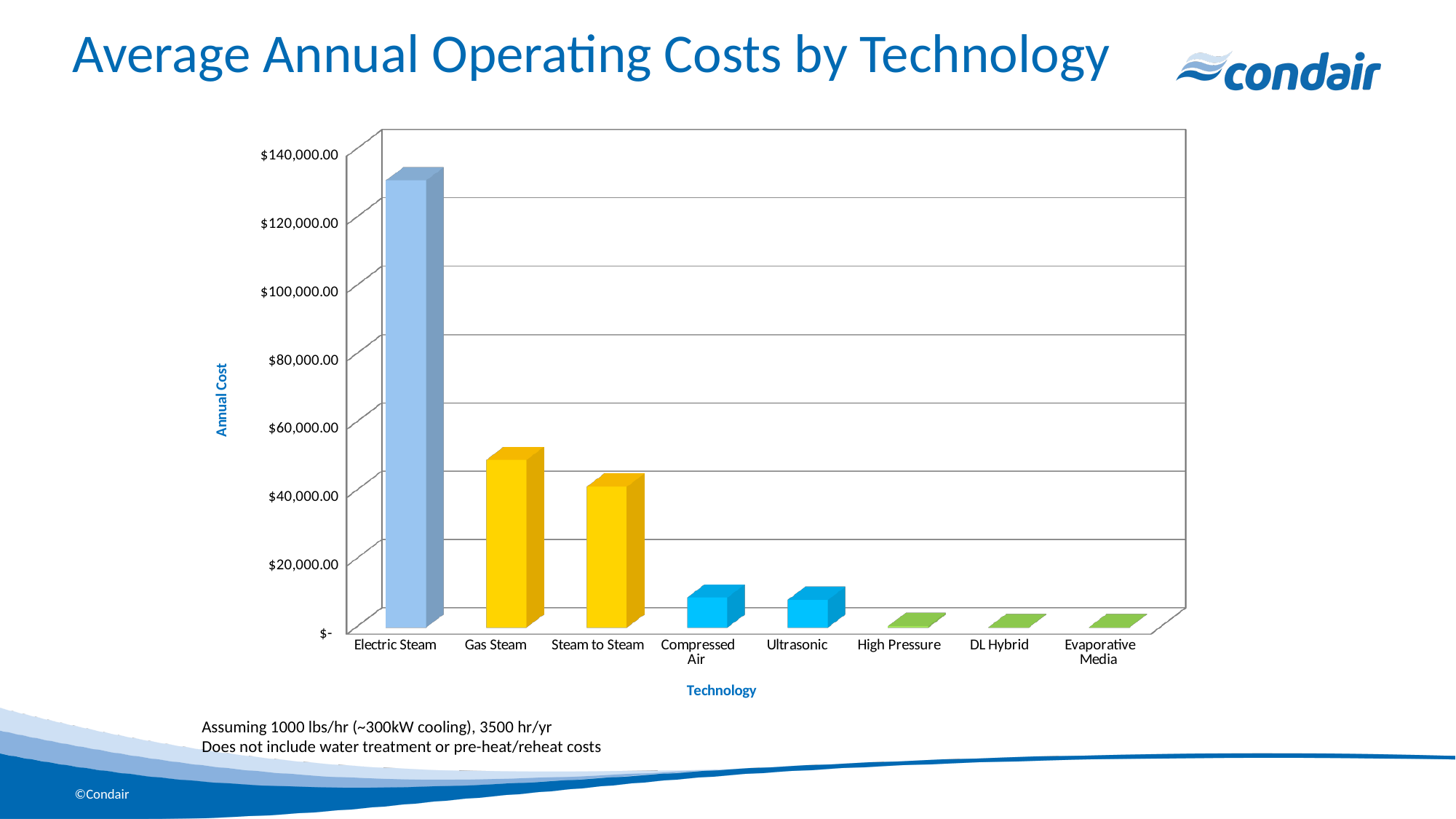
What kind of chart is shown on the slide? Bar chart Is the value for Electric Steam greater or less than $120,000.00? greater Which has a higher annual cost, Electric Steam or Gas Steam? Electric Steam Is the value for Compressed Air greater or less than $20,000.00? less Do the annual cost values generally rise or fall moving left to right along the x axis? Fall What is the title of the vertical axis of the chart? Annual Cost Is the value for Steam to Steam greater or less than $60,000.00? less How many technologies are shown on the x axis of the chart? 8 Which has a higher annual cost, Gas Steam or Steam to Steam? Gas Steam Which technology has the highest average annual operating cost? Electric Steam